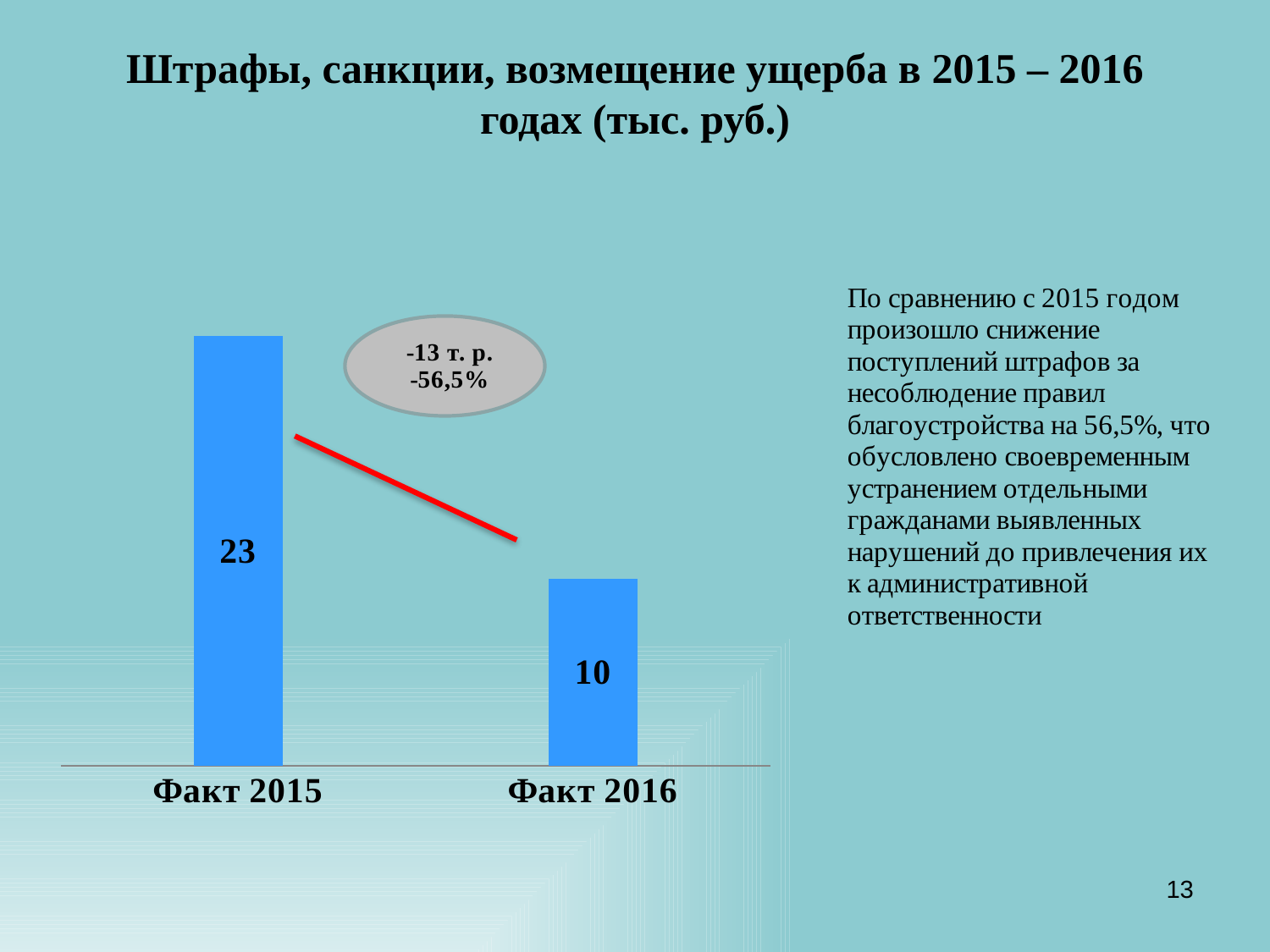
What kind of chart is shown on the slide? bar chart What is the value for Факт 2015? 23 Do the values rise or fall from Факт 2015 to Факт 2016? fall Which category has the highest value? Факт 2015 Which category has the lowest value? Факт 2016 What percentage change is shown in the oval annotation on the chart? -56,5% How many categories are shown in the chart? 2 What is the title of the chart on the slide? Штрафы, санкции, возмещение ущерба в 2015 – 2016 годах (тыс. руб.) What is the value for Факт 2016? 10 Which is larger, the value for Факт 2015 or Факт 2016? Факт 2015 What is the difference between the values for Факт 2015 and Факт 2016? 13